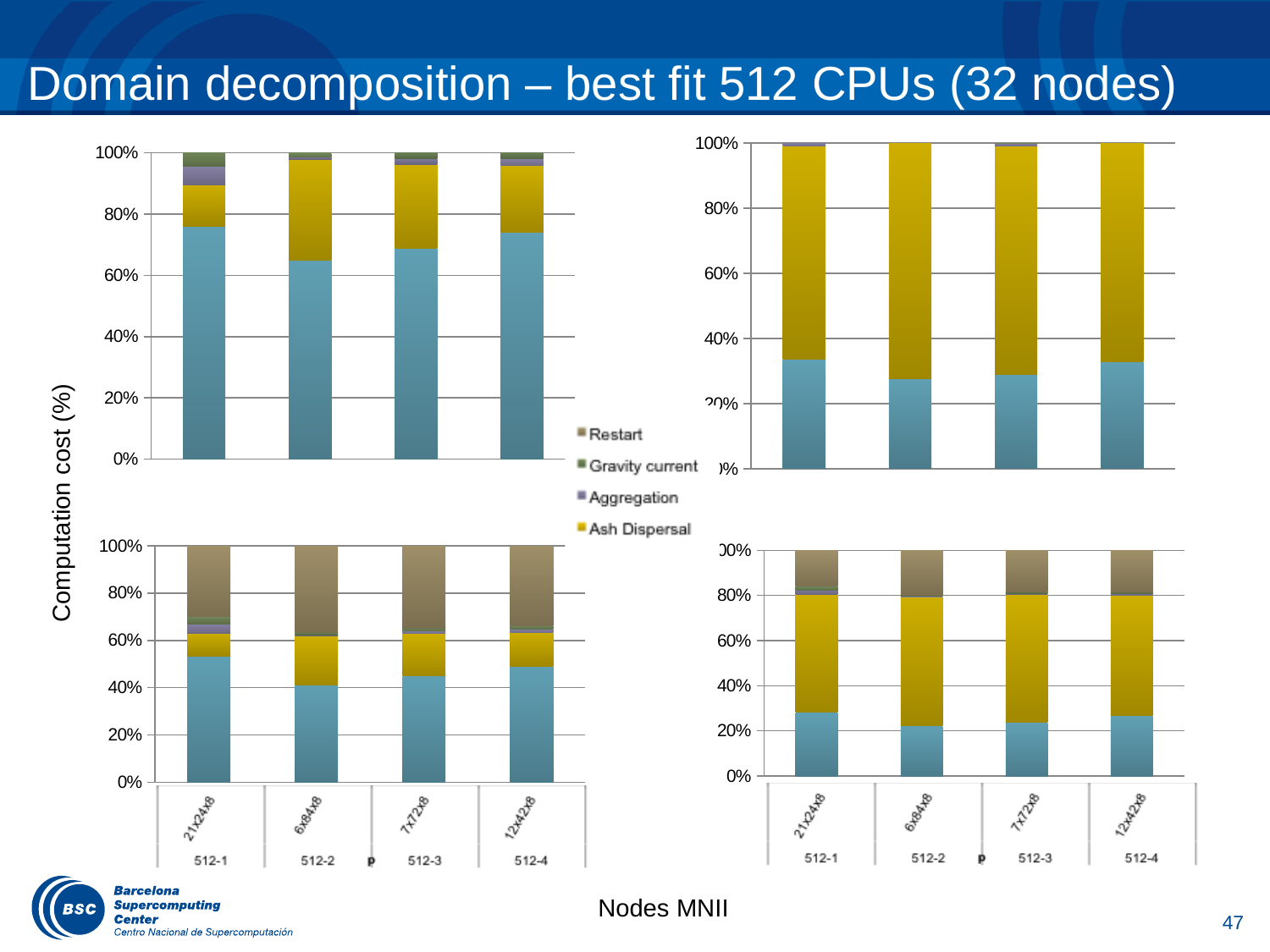
In the top-left chart, which has the larger blue (bottom) segment, 512-1 or 512-2? 512-1 Which legend entry is shown in yellow? Ash Dispersal How many series does the legend in the middle of the slide list? 4 In the top-right chart, is the blue (bottom) segment for 512-2 greater or less than 40%? less In the top-right chart, what is the total height of the stacked bar for 512-1? 100% How many categories are shown along the x axis of the bottom-left chart? 4 What is the label on the vertical axis shared by the charts on the slide? Computation cost (%) In the bottom-left chart, which has the larger blue (bottom) segment, 512-1 or 512-2? 512-1 In the top-left chart, is the blue (bottom) segment for 512-1 greater or less than 60%? greater In the bottom-left chart, is the blue (bottom) segment for 512-1 greater or less than 40%? greater What kind of chart is the top-left chart on the slide? stacked bar chart